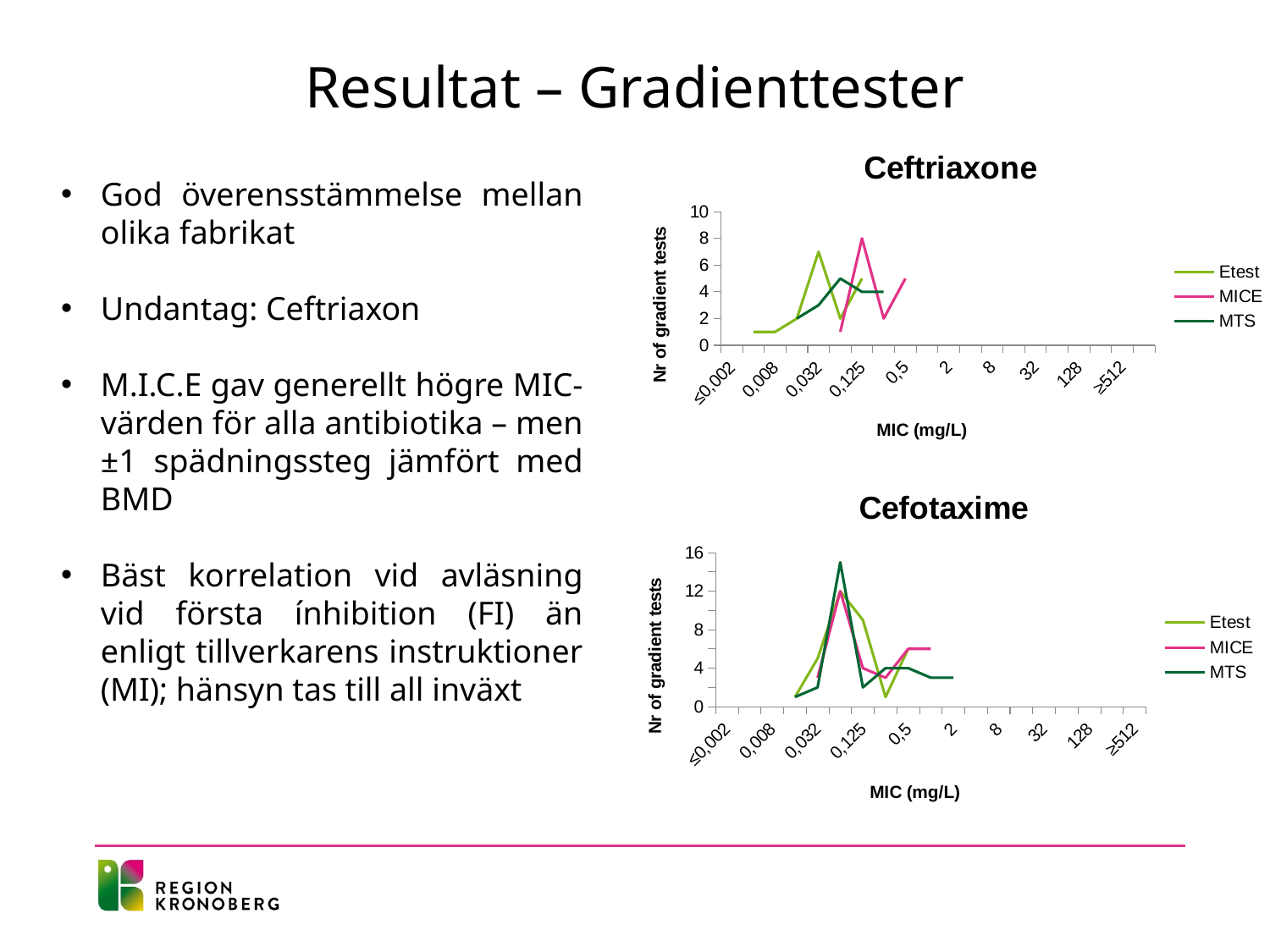
In the Cefotaxime chart, is the peak value of the Etest series greater or less than 8? greater In the Cefotaxime chart, is the peak value of the MTS series greater or less than 12? greater In the Ceftriaxone chart, is the peak value of the MTS series greater or less than 6? less What is the highest value shown on the y axis of the Cefotaxime chart? 16 In the Cefotaxime chart, which series reaches the highest peak? MTS In the Ceftriaxone chart, which series are listed in the legend? Etest, MICE, MTS What kind of chart is the Ceftriaxone chart? line chart In the Ceftriaxone chart, is the peak of the Etest series higher or lower than the peak of the MTS series? higher What is the x-axis title of the Cefotaxime chart? MIC (mg/L) How many MIC category labels are shown on the x axis of the Ceftriaxone chart? 10 How many series does the legend of the Cefotaxime chart list? 3